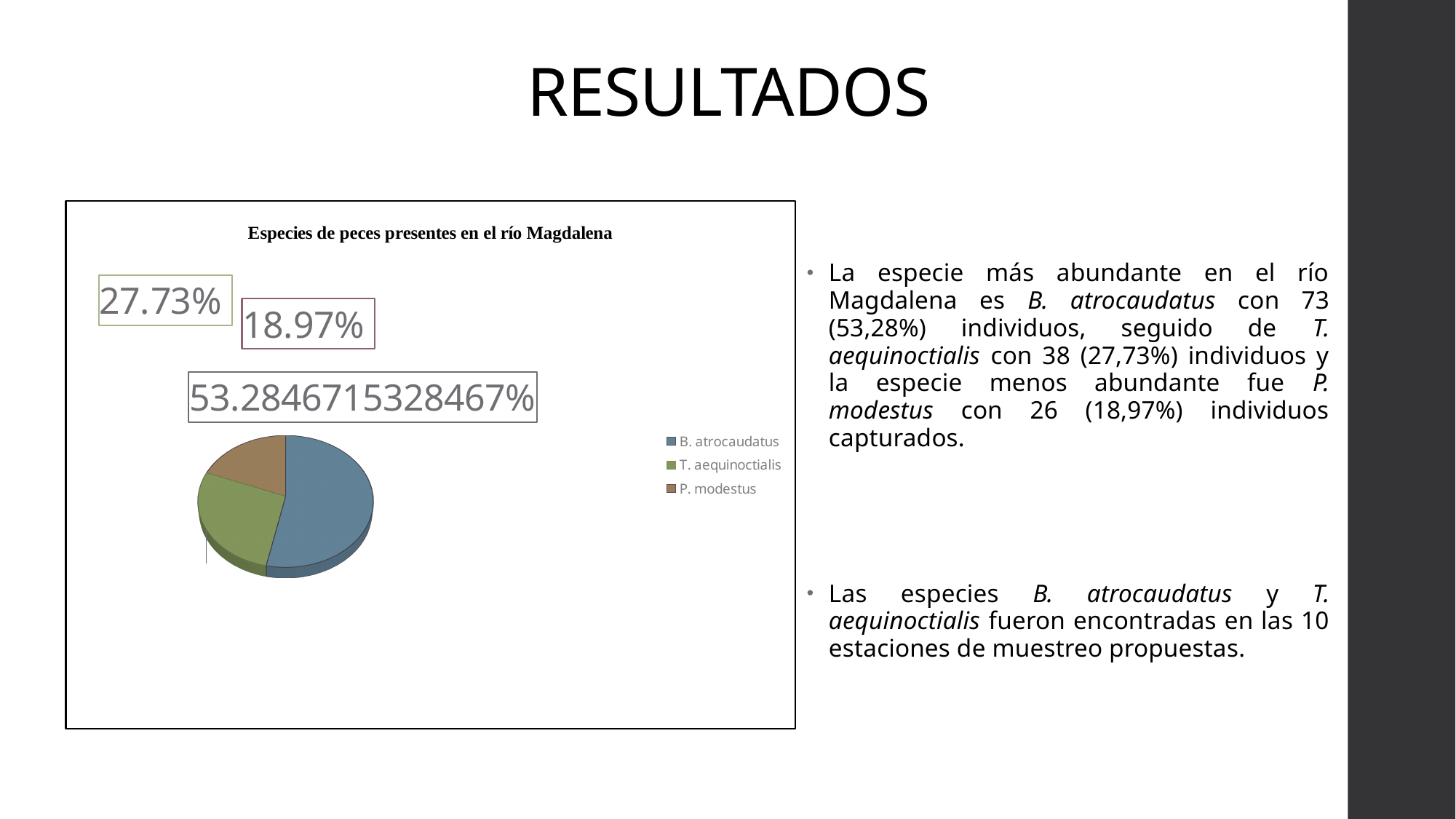
How many entries does the chart legend list? 3 Which species has the largest slice of the pie? B. atrocaudatus Which slice is larger, T. aequinoctialis or P. modestus? T. aequinoctialis Which species has the smallest slice of the pie? P. modestus What is the difference in percentage points between T. aequinoctialis (27.73%) and P. modestus (18.97%)? 8.76% What colour represents B. atrocaudatus in the pie chart? blue What kind of chart is shown on the slide? pie chart What percentage is shown for B. atrocaudatus? 53.2846715328467% How many species (slices) does the pie chart show? 3 What percentage is shown for P. modestus? 18.97% What percentage is shown for T. aequinoctialis? 27.73% What is the title of the chart? Especies de peces presentes en el río Magdalena